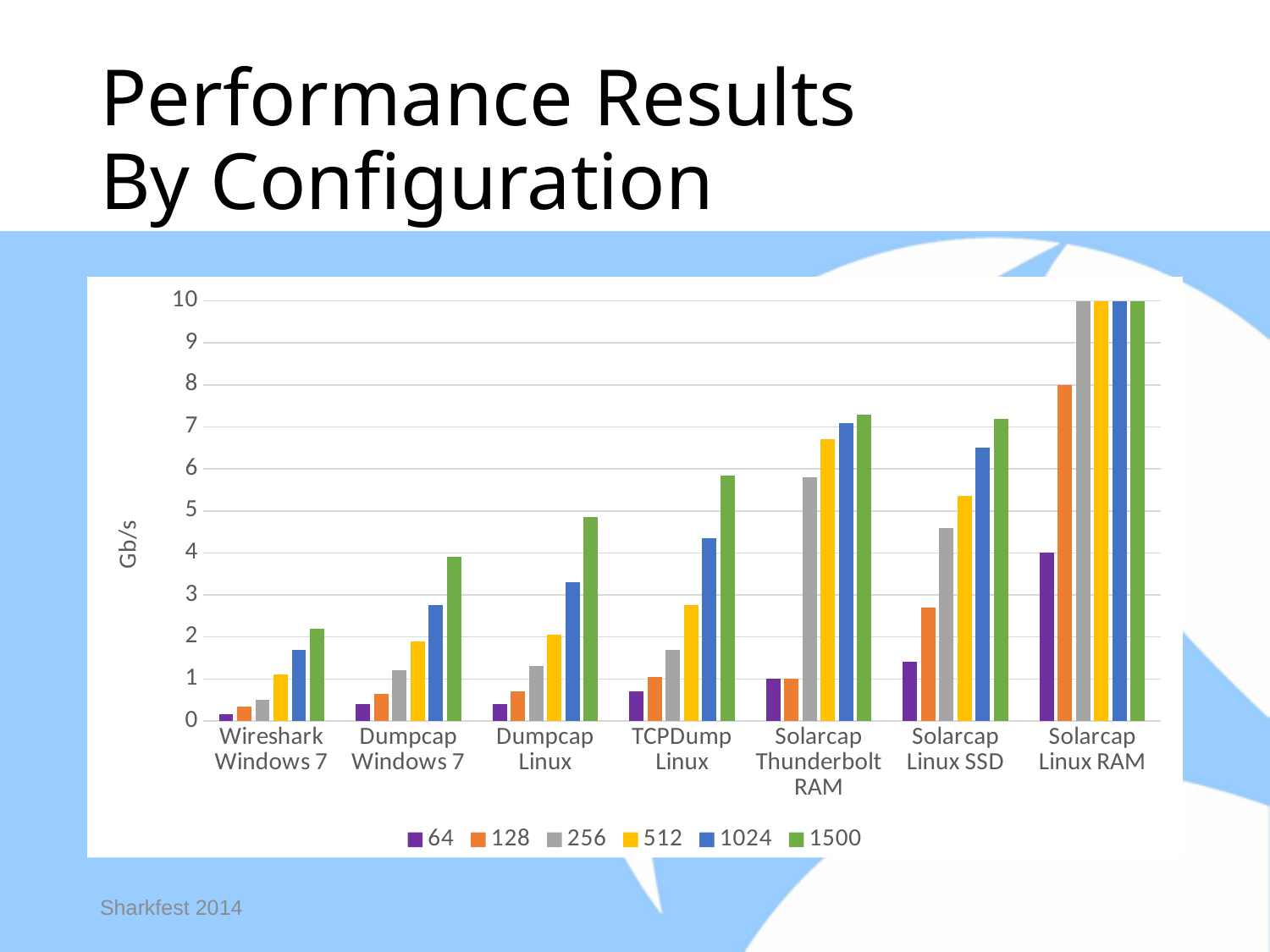
Which configuration has the lowest value for the 64 series? Wireshark Windows 7 Which configuration has the highest value for the 1500 series? Solarcap Linux RAM Is the value for the 1500 series for TCPDump Linux greater or less than 5? greater Which is larger for Solarcap Linux SSD: the 512 series or the 1024 series? 1024 What is the value for the 1500 series for Solarcap Linux RAM? 10 What is the label on the y axis? Gb/s How many series does the legend list? 6 What is the value for the 128 series for Solarcap Linux RAM? 8 What is the value for the 64 series for Solarcap Linux RAM? 4 How many configurations are shown along the x axis? 7 What kind of chart is shown on the slide? bar chart Is the value for the 1024 series for Dumpcap Windows 7 greater or less than 3? less